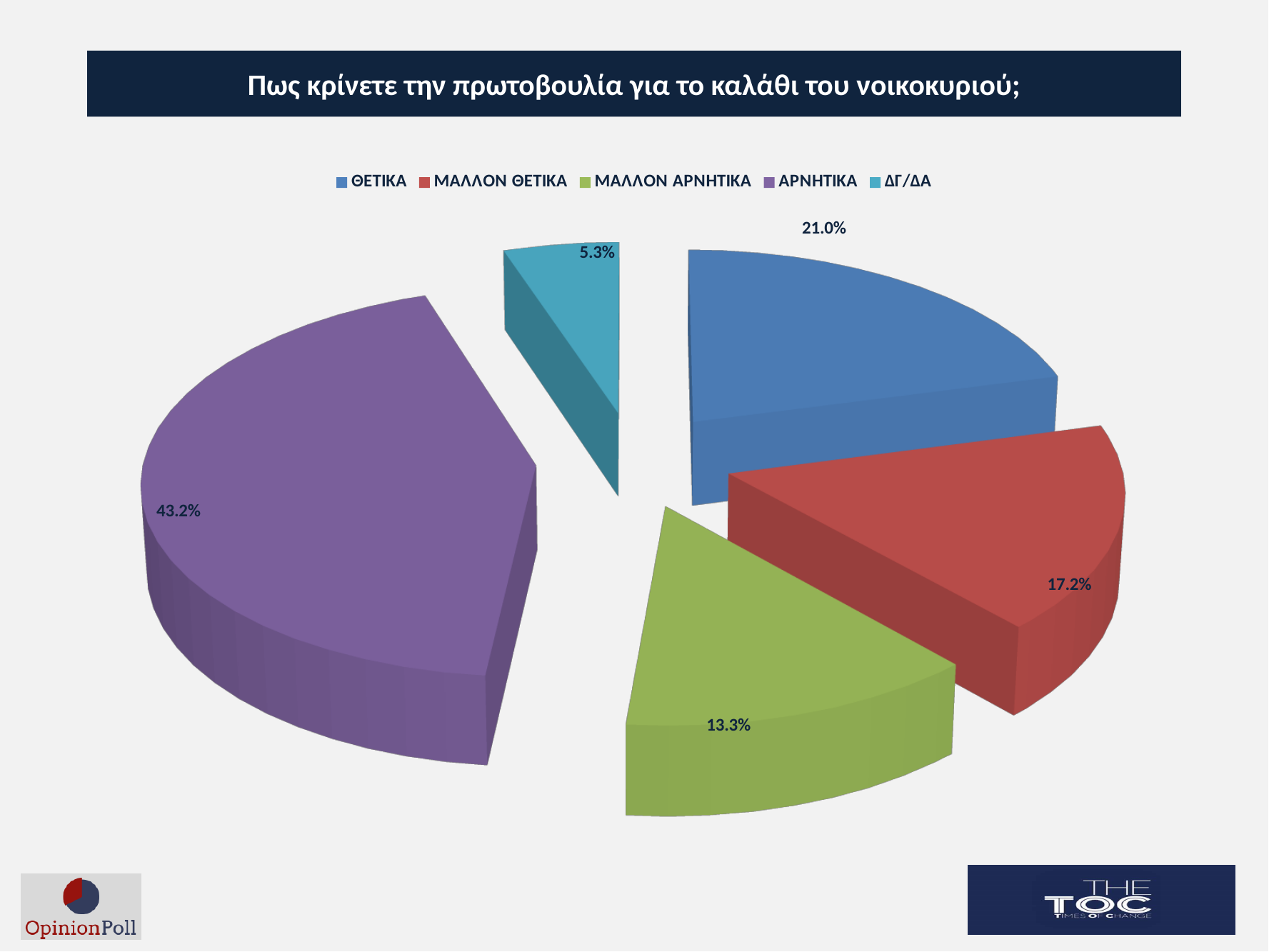
How many categories does the pie chart show? 5 Which category has the largest slice? ΑΡΝΗΤΙΚΑ Which is larger, ΜΑΛΛΟΝ ΘΕΤΙΚΑ or ΜΑΛΛΟΝ ΑΡΝΗΤΙΚΑ? ΜΑΛΛΟΝ ΘΕΤΙΚΑ What is the difference between ΑΡΝΗΤΙΚΑ and ΘΕΤΙΚΑ? 22.2% What is the value for ΜΑΛΛΟΝ ΑΡΝΗΤΙΚΑ? 13.3% Which category has the smallest slice? ΔΓ/ΔΑ What is the value for ΜΑΛΛΟΝ ΘΕΤΙΚΑ? 17.2% What is the value for ΘΕΤΙΚΑ? 21.0% What is the value for ΔΓ/ΔΑ? 5.3% What share of the pie does ΑΡΝΗΤΙΚΑ have? 43.2% What colour is the ΑΡΝΗΤΙΚΑ slice? Purple What kind of chart is shown on the slide? Pie chart